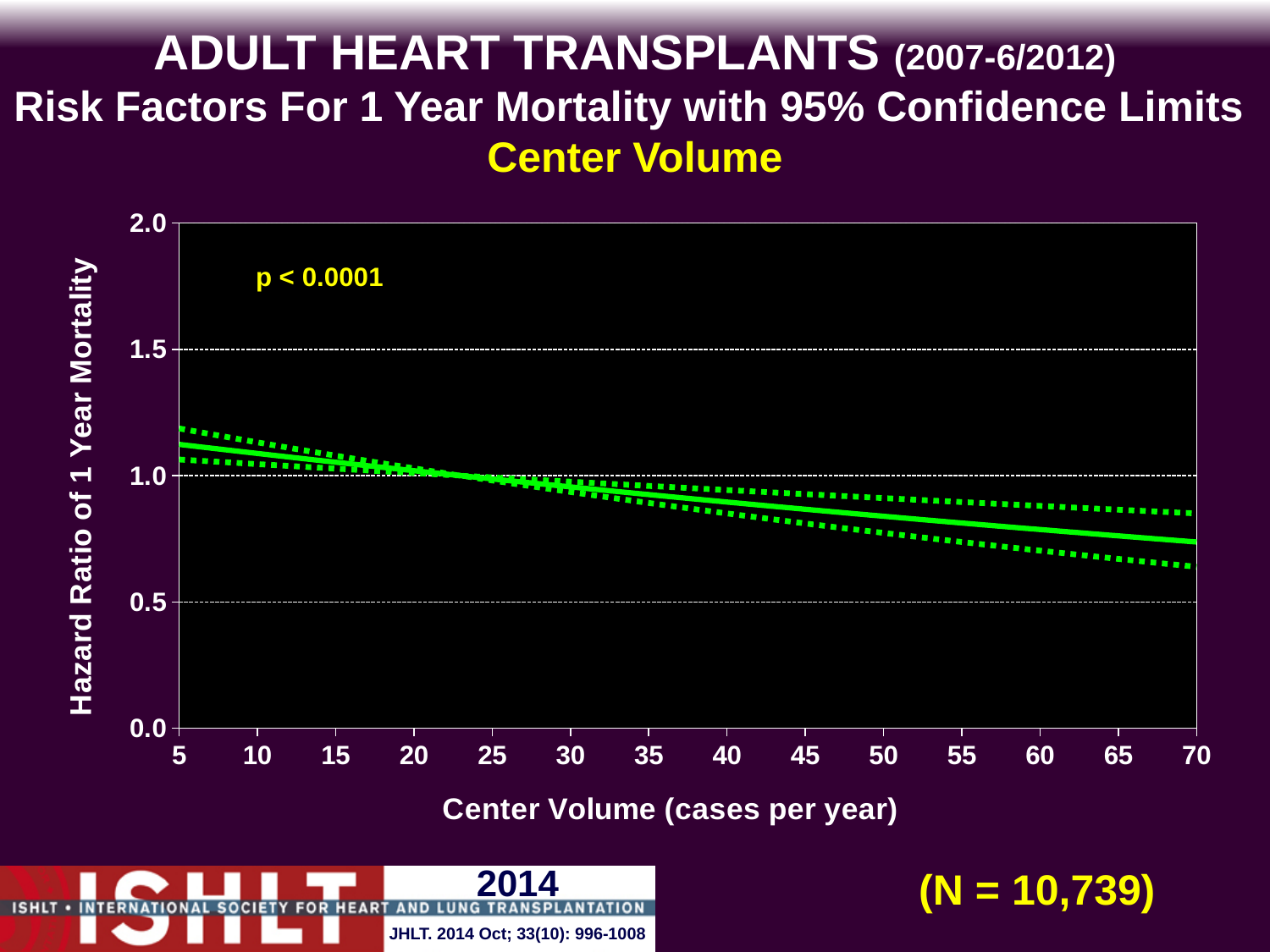
How many lines (solid and dotted) are plotted on the chart? 3 What is the label of the x axis? Center Volume (cases per year) Is the hazard ratio at a center volume of 70 cases per year greater or less than 0.5? greater Does the hazard ratio of 1 year mortality rise or fall as center volume increases along the x axis? fall What kind of chart is shown on the slide? line chart Is the hazard ratio at a center volume of 70 cases per year greater or less than 1.0? less Is the hazard ratio at a center volume of 5 cases per year greater or less than 1.0? greater Is the hazard ratio at a center volume of 5 cases per year larger or smaller than at 70 cases per year? larger What is the p-value shown on the chart? p < 0.0001